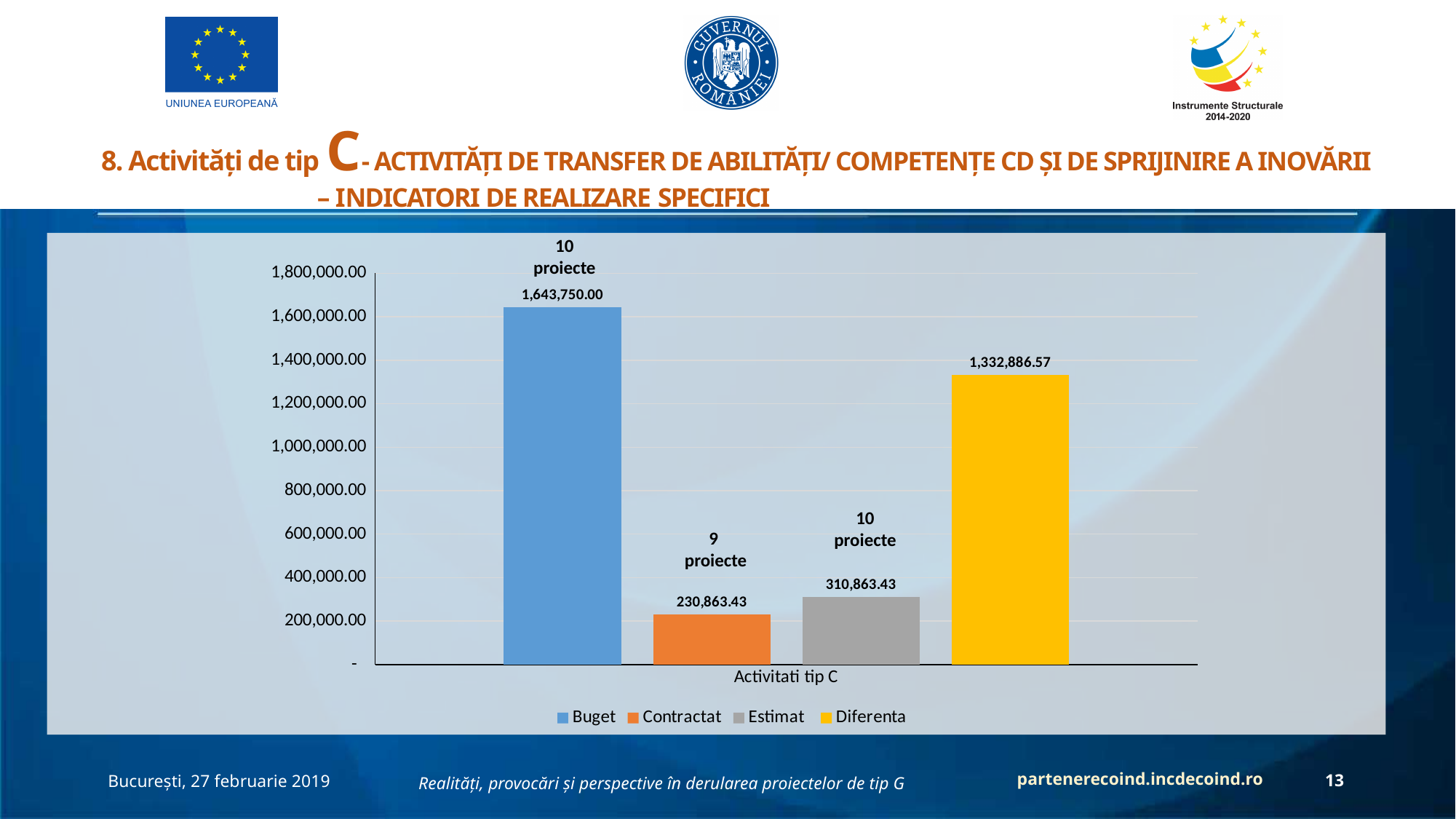
What kind of chart is shown on the slide? Bar chart How many series does the legend list? 4 How many projects are annotated above the Contractat bar? 9 proiecte What is the difference between the Estimat and Contractat values? 80,000.00 What is the value of the Buget bar for Activitati tip C? 1,643,750.00 Which series has the lowest value? Contractat What is the value of the Estimat bar? 310,863.43 What is the value of the Contractat bar? 230,863.43 What is the difference between the Buget and Diferenta values? 310,863.43 What is the value of the Diferenta bar? 1,332,886.57 Which is larger, the Estimat value or the Contractat value? Estimat Which series has the highest value? Buget